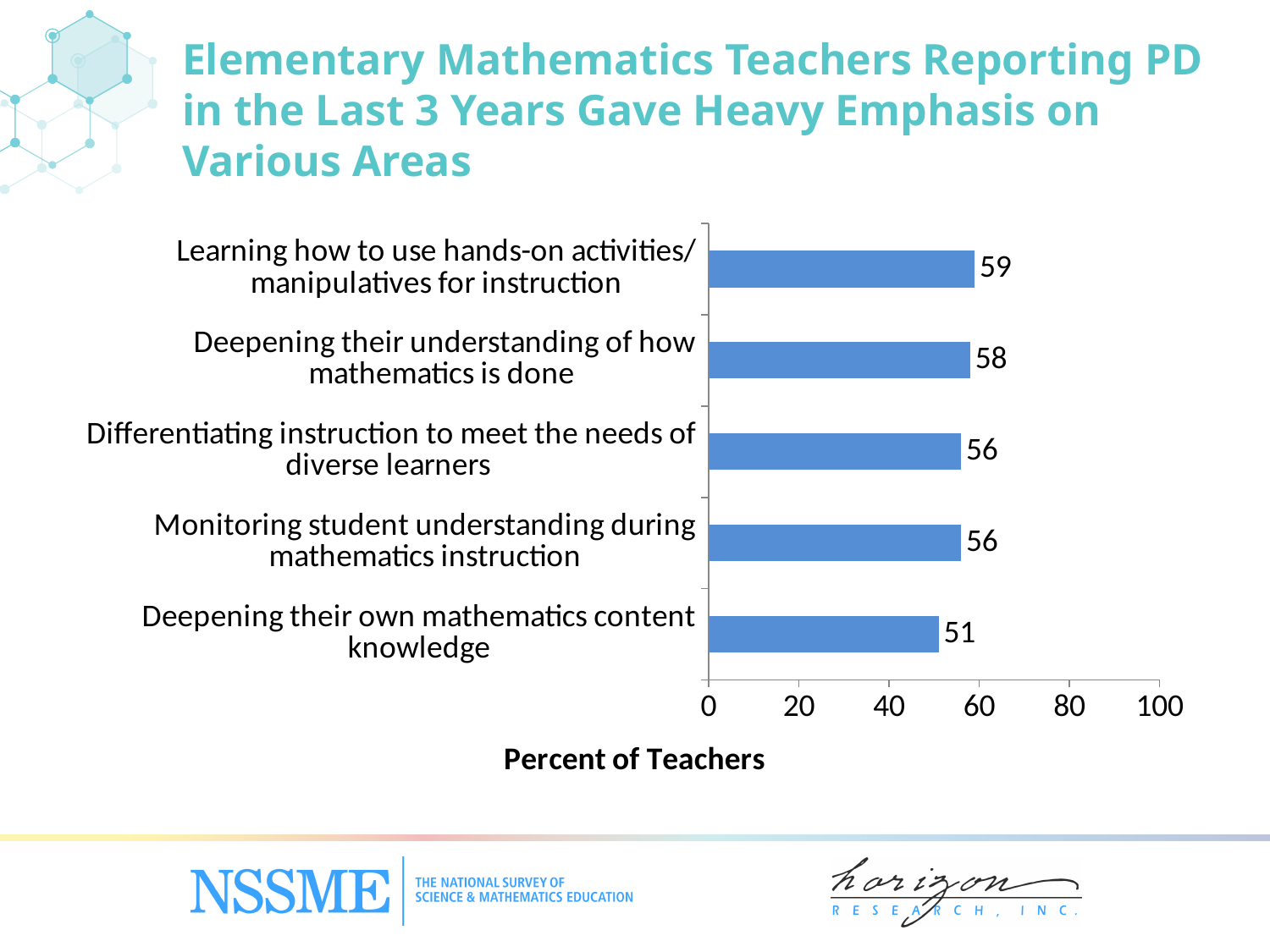
What is the value for deepening their own mathematics content knowledge? 51 What is the difference between the values for deepening their understanding of how mathematics is done and monitoring student understanding during mathematics instruction? 2 Is the value for monitoring student understanding during mathematics instruction greater or less than 40? greater How many areas are shown in the chart? 5 What is the label of the horizontal axis? Percent of Teachers Which area has the lowest percent of teachers? Deepening their own mathematics content knowledge Which is larger: the value for deepening their understanding of how mathematics is done or the value for deepening their own mathematics content knowledge? Deepening their understanding of how mathematics is done What percent of teachers reported heavy emphasis on learning how to use hands-on activities/manipulatives for instruction? 59 What is the value for differentiating instruction to meet the needs of diverse learners? 56 Which area has the highest percent of teachers? Learning how to use hands-on activities/manipulatives for instruction What kind of chart is shown on the slide? Bar chart What is the difference between the values for learning how to use hands-on activities/manipulatives for instruction and deepening their own mathematics content knowledge? 8